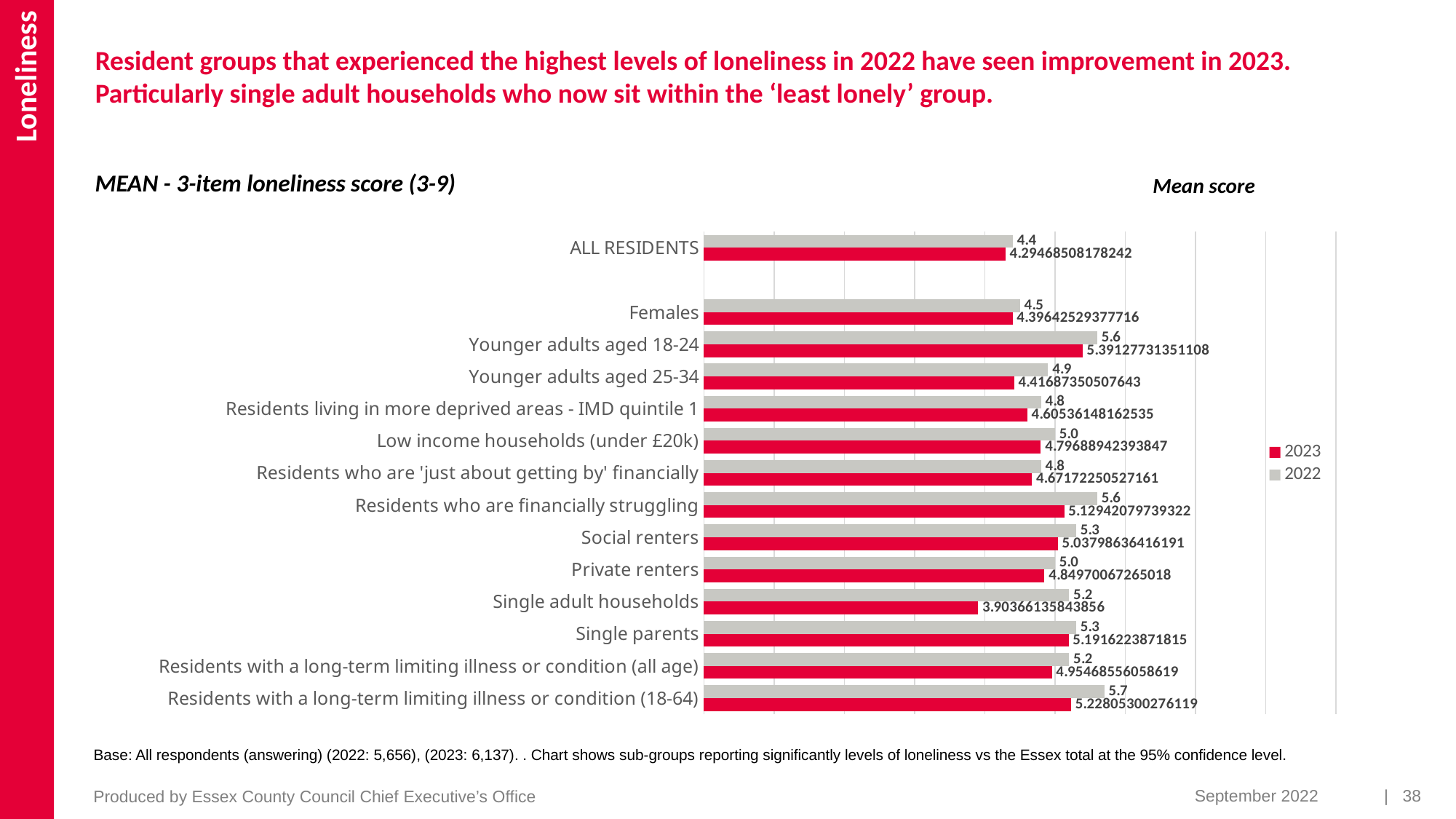
What is the difference between the 2022 scores for Residents with a long-term limiting illness or condition (18-64) and ALL RESIDENTS? 1.3 Which resident group has the highest 2023 mean loneliness score? Younger adults aged 18-24 Which is larger: the 2023 score for Social renters or the 2023 score for Single adult households? Social renters What is the 2022 mean loneliness score for Residents who are financially struggling? 5.6 How many resident groups (categories) are plotted in the chart? 14 How many series does the legend list? 2 What is the 2023 mean loneliness score for Single adult households? 3.90366135843856 What kind of chart is shown on the slide? bar chart Which resident group has the lowest 2023 mean loneliness score? Single adult households What is the 2022 mean loneliness score for ALL RESIDENTS? 4.4 Which resident group has the highest 2022 mean loneliness score? Residents with a long-term limiting illness or condition (18-64) Which colour represents the 2023 series in the chart? red